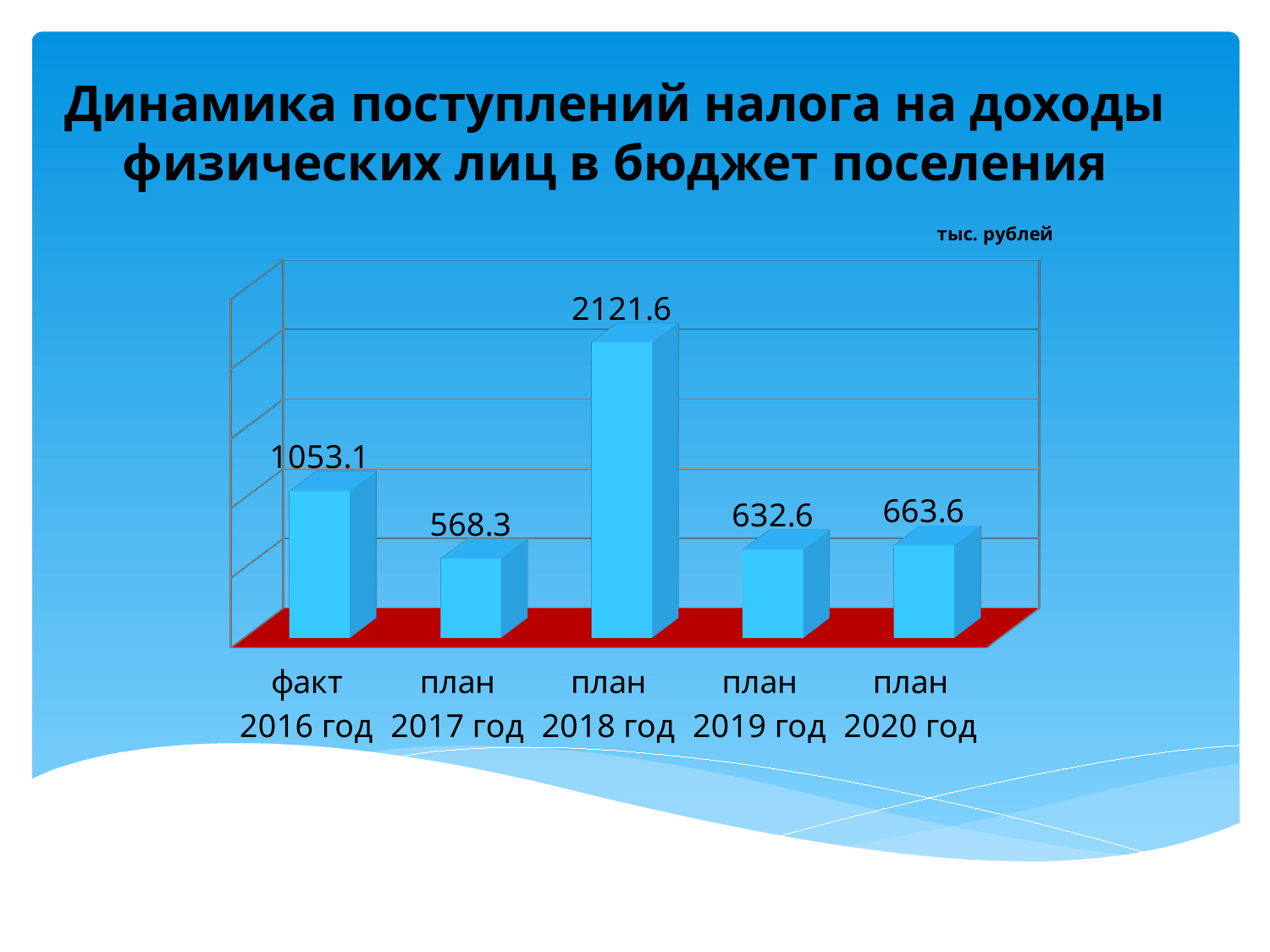
How many categories are shown on the chart? 5 What is the value for факт 2016 год? 1053.1 Which category has the highest value? план 2018 год Which is larger, the value for факт 2016 год or the value for план 2019 год? факт 2016 год What is the value for план 2018 год? 2121.6 What kind of chart is shown on the slide? bar chart What is the value for план 2017 год? 568.3 What is the difference between the values for план 2018 год and факт 2016 год? 1068.5 What unit of measurement is indicated above the chart? тыс. рублей What is the difference between the values for план 2020 год and план 2019 год? 31 What is the value for план 2020 год? 663.6 Which category has the lowest value? план 2017 год